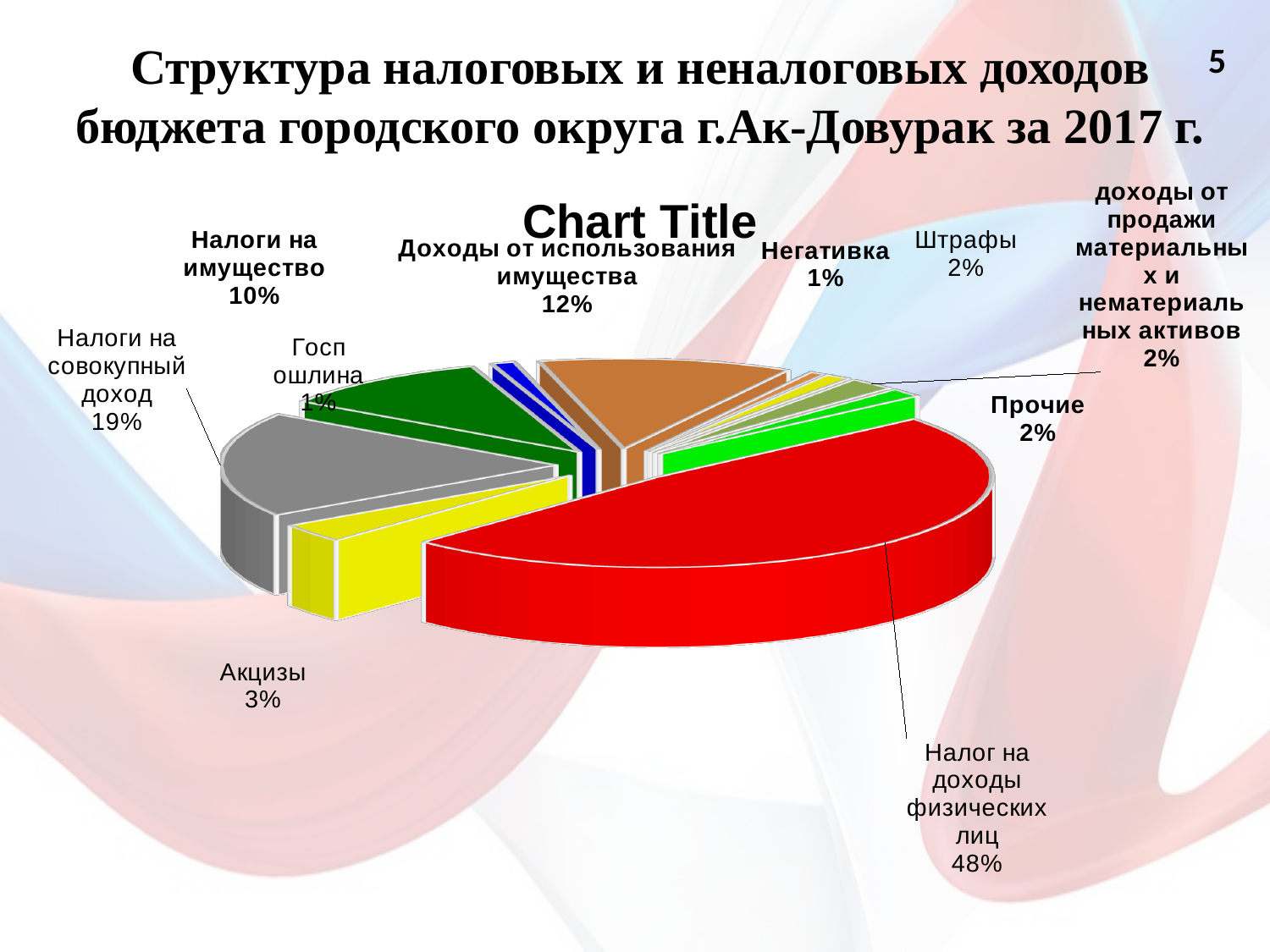
How many slices does the pie chart have? 10 What kind of chart is shown on the slide? Pie chart What is the value shown for Доходы от использования имущества? 12% What is the value shown for Акцизы? 3% Which category has the largest slice of the pie? Налог на доходы физических лиц What is the difference between the shares of Налог на доходы физических лиц and Налоги на совокупный доход? 29% What title is printed above the pie chart? Chart Title What is the value shown for Штрафы? 2% Which is larger, the share for Доходы от использования имущества or the share for Налоги на имущество? Доходы от использования имущества What share of the pie does Налог на доходы физических лиц represent? 48% What is the value shown for Налоги на совокупный доход? 19% What is the difference between the shares of Налоги на совокупный доход and Налоги на имущество? 9%